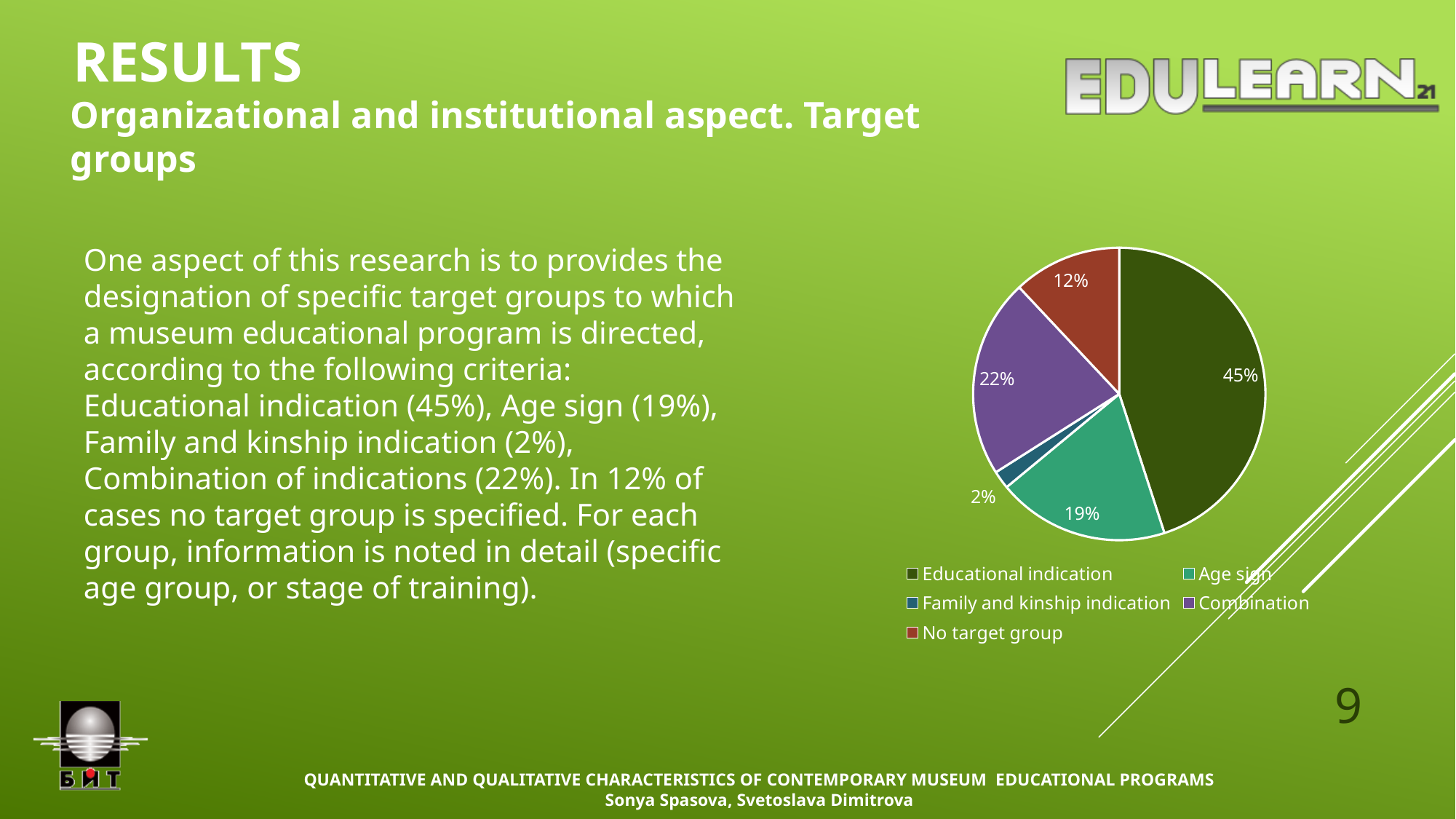
Which category has the smallest slice of the pie? Family and kinship indication What share of the pie does Combination have? 22% What share of the pie does No target group have? 12% What share of the pie does Age sign have? 19% How many categories does the pie chart show? 5 Which category has the largest slice of the pie? Educational indication What is the difference between the shares for Educational indication and Combination? 23% What share of the pie does Educational indication have? 45% What share of the pie does Family and kinship indication have? 2% Which is larger, the share for Age sign or the share for No target group? Age sign What colour is the slice for Combination? Purple What kind of chart is shown on the slide? Pie chart